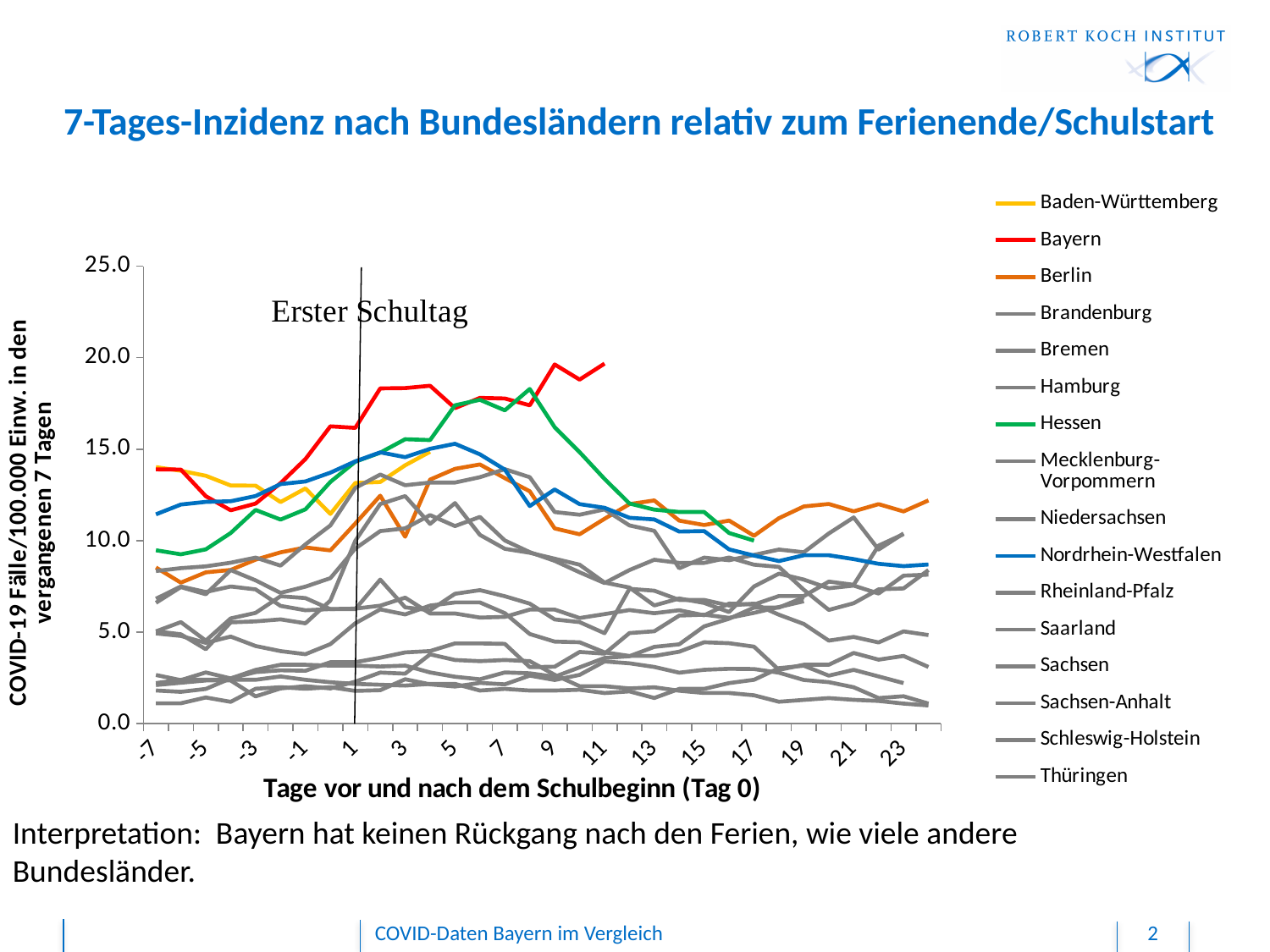
What is the title of the chart? 7-Tages-Inzidenz nach Bundesländern relativ zum Ferienende/Schulstart Is the value for Berlin at day -5 greater or less than 10.0? less What label is written next to the vertical line in the chart? Erster Schultag At day 11, which is larger: the value for Bayern or the value for Hessen? Bayern Does the value for Hessen rise or fall between day 9 and day 17? fall What kind of chart is shown on the slide? line chart Which series reaches the highest value anywhere on the chart? Bayern How many series does the legend list? 16 Is the value for Bayern at day 11 greater or less than 15.0? greater Does the value for Bayern rise or fall between day 1 and day 11? rise Is the value for Hessen at day -7 greater or less than 10.0? less